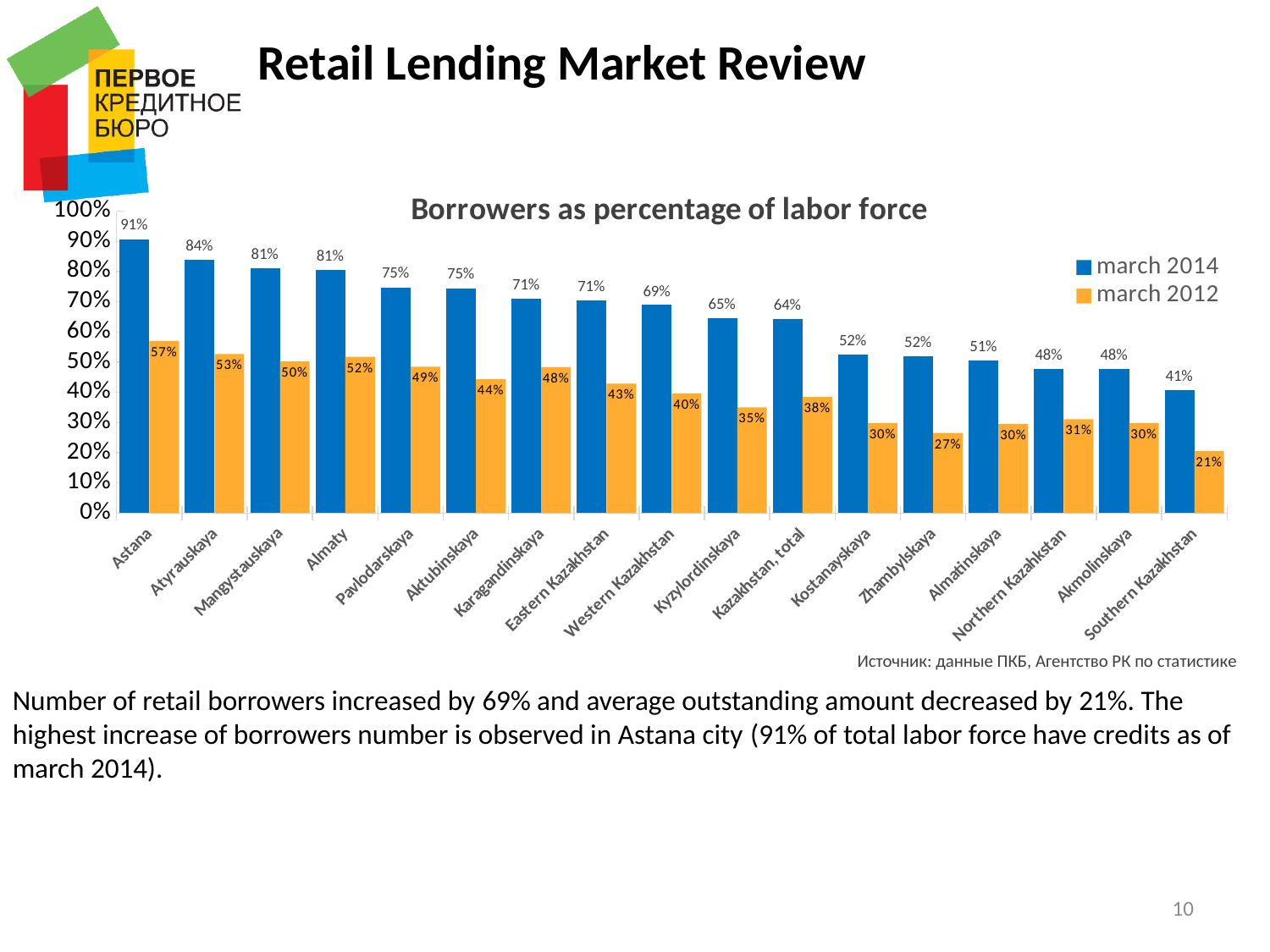
What is the difference between the march 2014 and march 2012 values for Astana? 34% How many series does the legend list? 2 What is the title of the chart? Borrowers as percentage of labor force What kind of chart is shown on the slide? Bar chart What is the march 2014 value for Astana? 91% Do the march 2014 values rise or fall from left to right along the x axis? Fall Which category has the highest march 2014 value? Astana What is the march 2012 value for Kazakhstan, total? 38% What is the march 2012 value for Southern Kazakhstan? 21% How many categories are shown on the x axis? 17 Which is larger for Kyzylordinskaya: the march 2014 value or the march 2012 value? march 2014 Which category has the lowest march 2012 value? Southern Kazakhstan